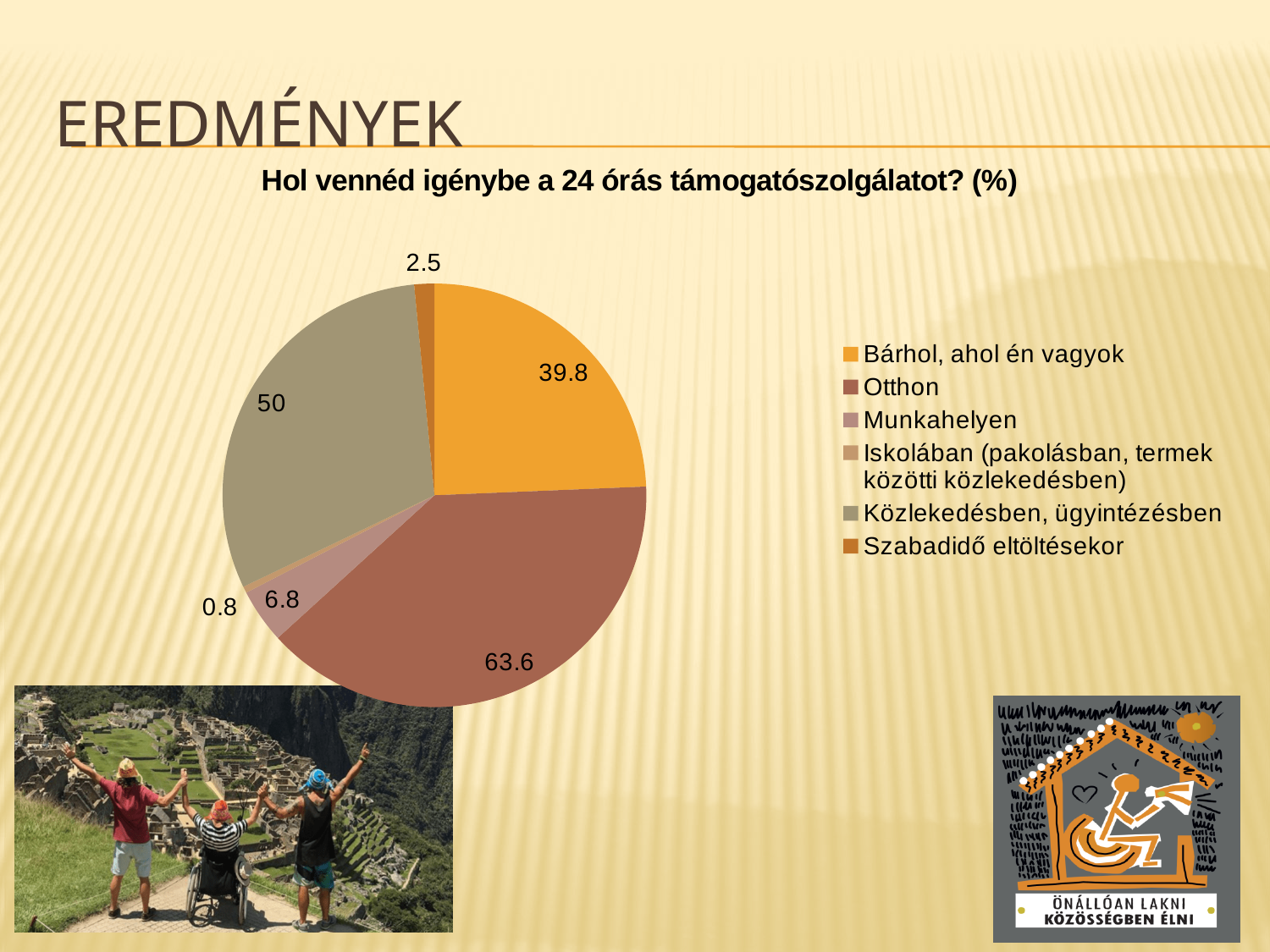
What type of chart is shown on the slide? pie chart Which is larger, the value for "Munkahelyen" or the value for "Szabadidő eltöltésekor"? Munkahelyen What is the value for "Munkahelyen"? 6.8 What is the difference between the values for "Otthon" and "Közlekedésben, ügyintézésben"? 13.6 Which category has the lowest value? Iskolában (pakolásban, termek közötti közlekedésben) What is the title of the chart? Hol vennéd igénybe a 24 órás támogatószolgálatot? (%) What is the value for "Otthon"? 63.6 What is the value for "Szabadidő eltöltésekor"? 2.5 What is the value for "Bárhol, ahol én vagyok"? 39.8 Which category has the highest value? Otthon How many categories does the legend list? 6 What is the value for "Közlekedésben, ügyintézésben"? 50